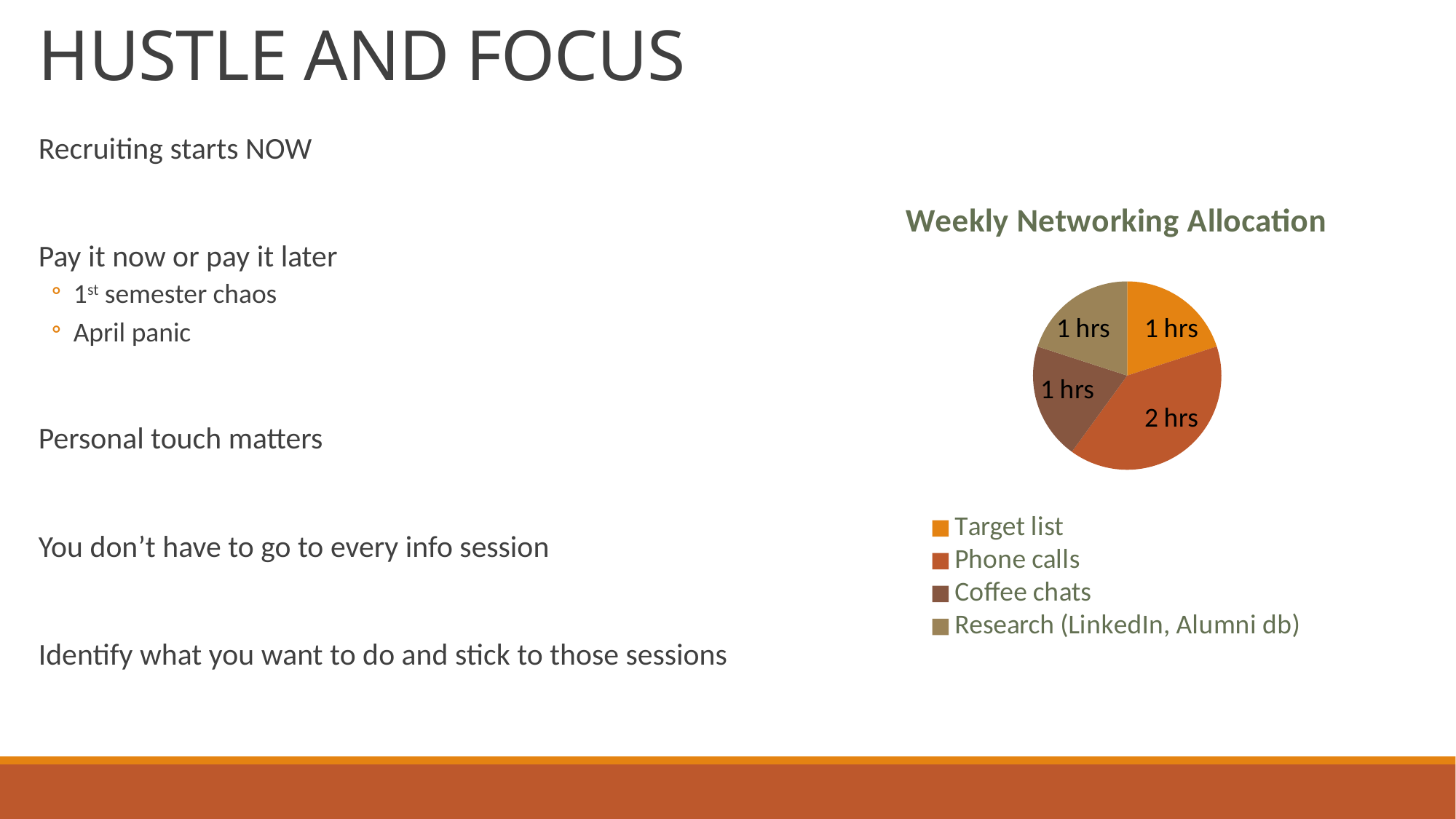
What type of chart is shown on the slide? Pie chart What is the title of the chart? Weekly Networking Allocation How many hours are allocated to Research (LinkedIn, Alumni db)? 1 hrs How many hours are allocated to Phone calls? 2 hrs What is the total number of hours shown across all slices? 5 hrs Which is larger, the allocation for Phone calls or for Target list? Phone calls How many hours are allocated to Target list? 1 hrs How many hours are allocated to Coffee chats? 1 hrs Which category has the largest allocation? Phone calls What share of the total weekly allocation does Phone calls represent? 40% What is the difference in hours between Phone calls and Coffee chats? 1 hrs How many categories does the pie chart have? 4